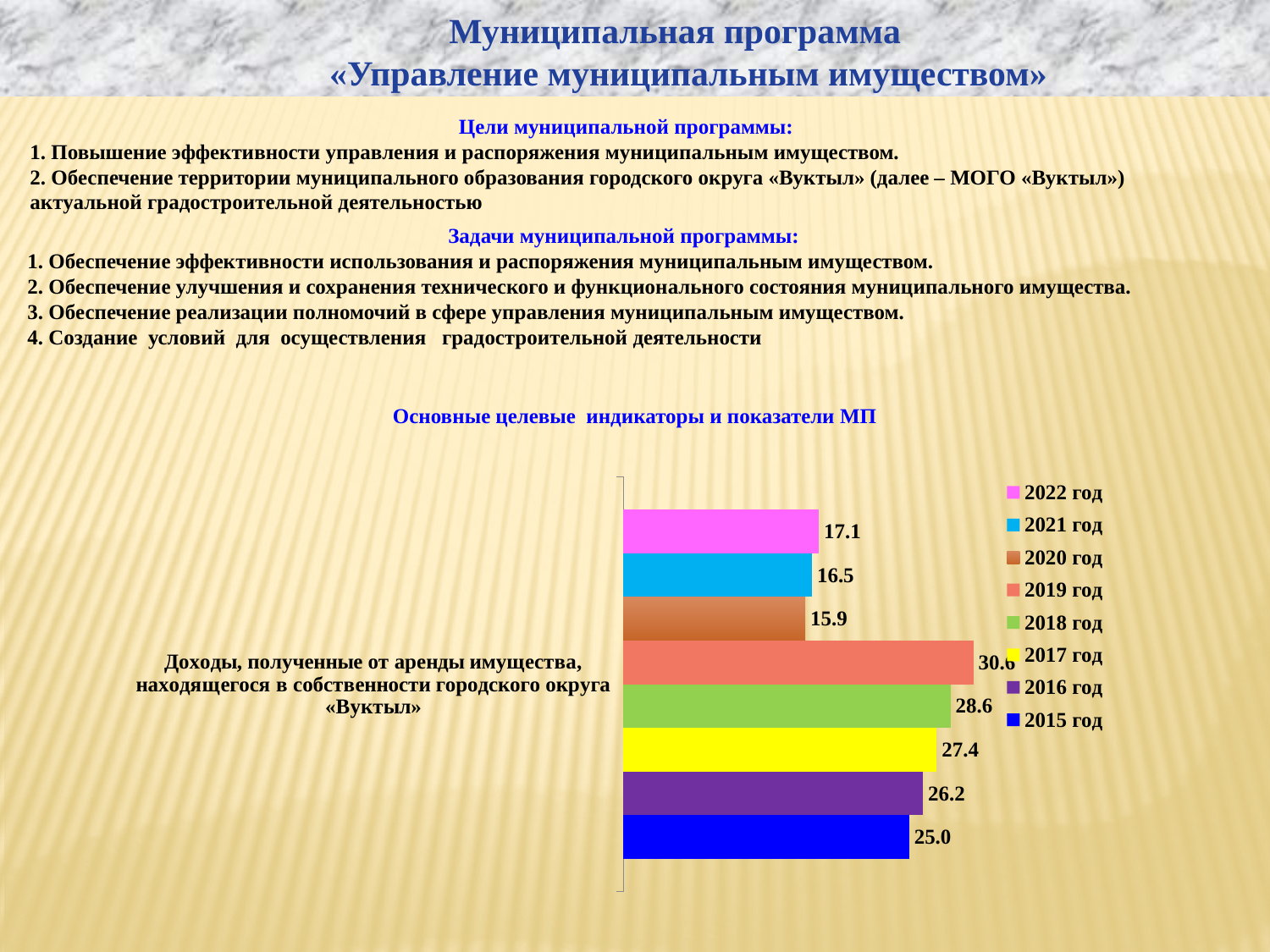
Which year has the highest value in the chart 'Доходы, полученные от аренды имущества'? 2019 год Which year has the lowest value in the chart 'Доходы, полученные от аренды имущества'? 2020 год What is the value for 2015 год in the chart 'Доходы, полученные от аренды имущества'? 25.0 What is the difference between the values for 2018 год and 2017 год in the chart 'Доходы, полученные от аренды имущества'? 1.2 Which is larger in the chart 'Доходы, полученные от аренды имущества': the value for 2021 год or the value for 2016 год? 2016 год What is the value for 2017 год in the chart 'Доходы, полученные от аренды имущества'? 27.4 How many series does the legend of the chart 'Доходы, полученные от аренды имущества' list? 8 What is the value for 2022 год in the chart 'Доходы, полученные от аренды имущества'? 17.1 In the chart 'Доходы, полученные от аренды имущества', what colour is the bar for 2017 год? yellow What is the value for 2020 год in the chart 'Доходы, полученные от аренды имущества'? 15.9 What kind of chart is 'Доходы, полученные от аренды имущества'? bar chart What is the difference between the values for 2016 год and 2015 год in the chart 'Доходы, полученные от аренды имущества'? 1.2